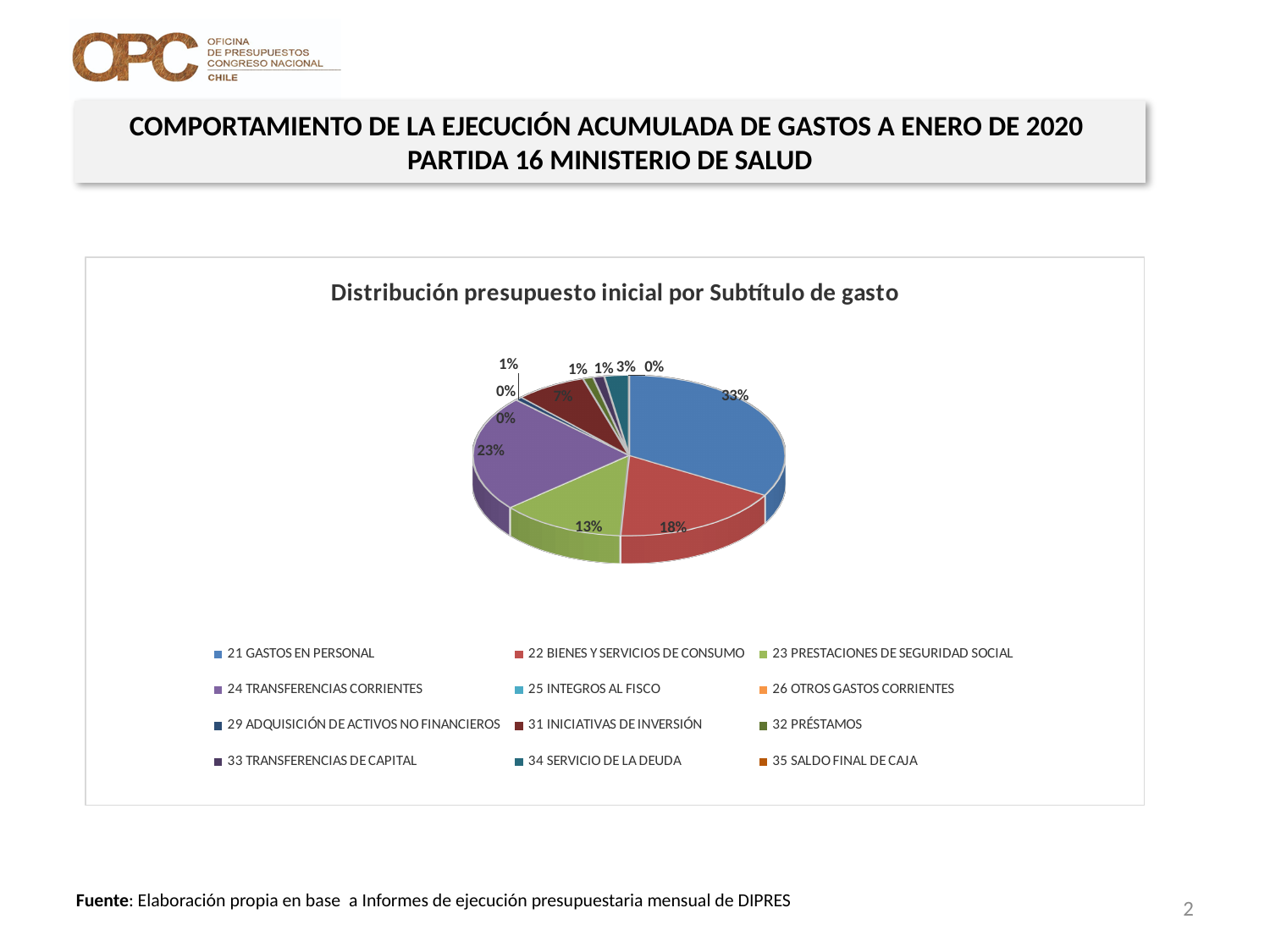
How many categories does the legend list? 12 What share of the pie does 21 GASTOS EN PERSONAL represent? 33% What is the title of the chart? Distribución presupuesto inicial por Subtítulo de gasto What is the difference in percentage points between 21 GASTOS EN PERSONAL and 22 BIENES Y SERVICIOS DE CONSUMO? 15 percentage points What share of the pie does 24 TRANSFERENCIAS CORRIENTES represent? 23% Which category has the largest slice of the pie? 21 GASTOS EN PERSONAL What is the combined share of 21 GASTOS EN PERSONAL and 24 TRANSFERENCIAS CORRIENTES? 56% Which is larger, the share for 22 BIENES Y SERVICIOS DE CONSUMO or for 24 TRANSFERENCIAS CORRIENTES? 24 TRANSFERENCIAS CORRIENTES What kind of chart is shown on the slide? Pie chart What percentage is shown for 23 PRESTACIONES DE SEGURIDAD SOCIAL? 13% What percentage is shown for 31 INICIATIVAS DE INVERSIÓN? 7% What percentage is shown for 22 BIENES Y SERVICIOS DE CONSUMO? 18%